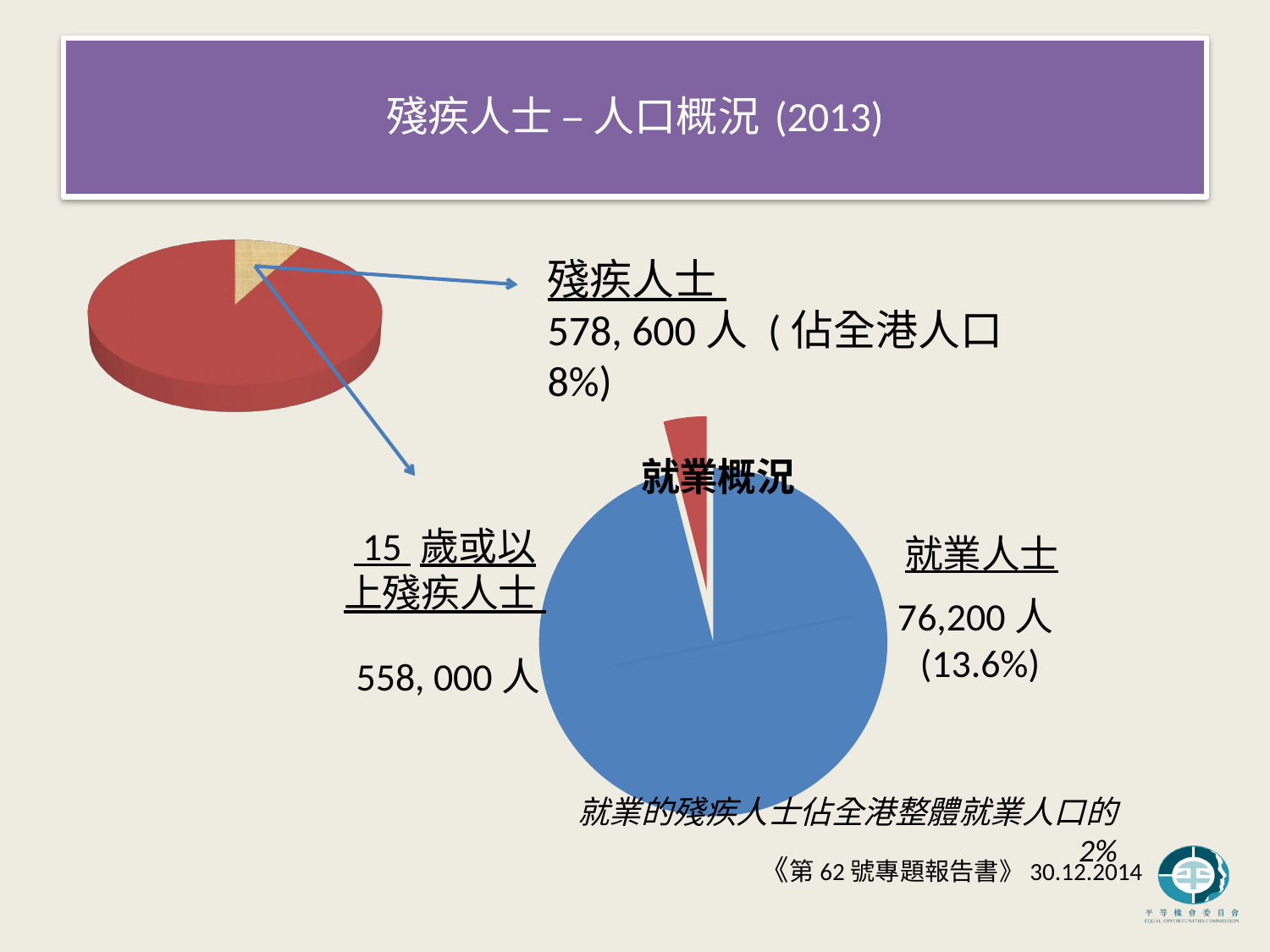
In the 就業概況 chart, what colour is the 就業人士 slice? red What is the title of the bottom pie chart? 就業概況 What kind of chart is the chart at the top left of the slide? pie chart In the 就業概況 chart, what is the difference between the number of 15 歲或以上殘疾人士 and the number of 就業人士? 481,800 人 In the top-left pie chart, how many 殘疾人士 are there according to the label? 578, 600 人 How many slices does the 就業概況 pie chart have? 2 In the 就業概況 chart, how many 就業人士 are there? 76,200 人 In the 就業概況 chart, which slice is larger, the blue slice or the red slice? the blue slice In the top-left pie chart, what share of the total population do 殘疾人士 make up? 8% What kind of chart is the 就業概況 chart? pie chart In the 就業概況 chart, what percentage do 就業人士 represent? 13.6% In the 就業概況 chart, how many 15 歲或以上殘疾人士 are there? 558, 000 人